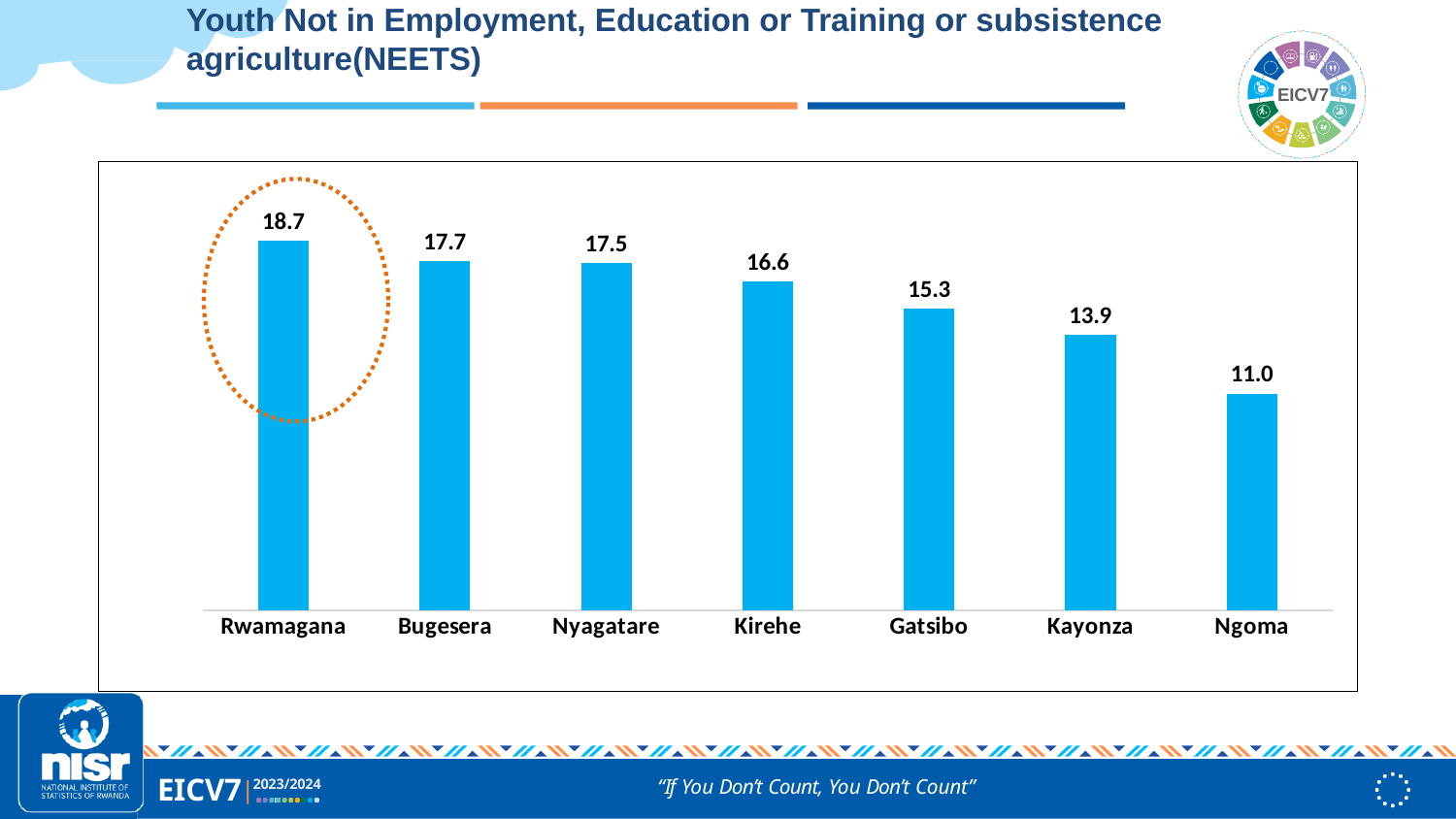
What is the difference between the values for Rwamagana and Ngoma? 7.7 What is the value for Kirehe? 16.6 Which district has the lowest value? Ngoma What kind of chart is shown on the slide? Bar chart What is the value for Rwamagana? 18.7 How many districts are shown in the chart? 7 What is the difference between the values for Gatsibo and Kayonza? 1.4 Do the values rise or fall from left to right across the districts? Fall Which is larger, the value for Bugesera or the value for Gatsibo? Bugesera Which district has the highest value? Rwamagana What is the value for Ngoma? 11.0 What is the value for Kayonza? 13.9